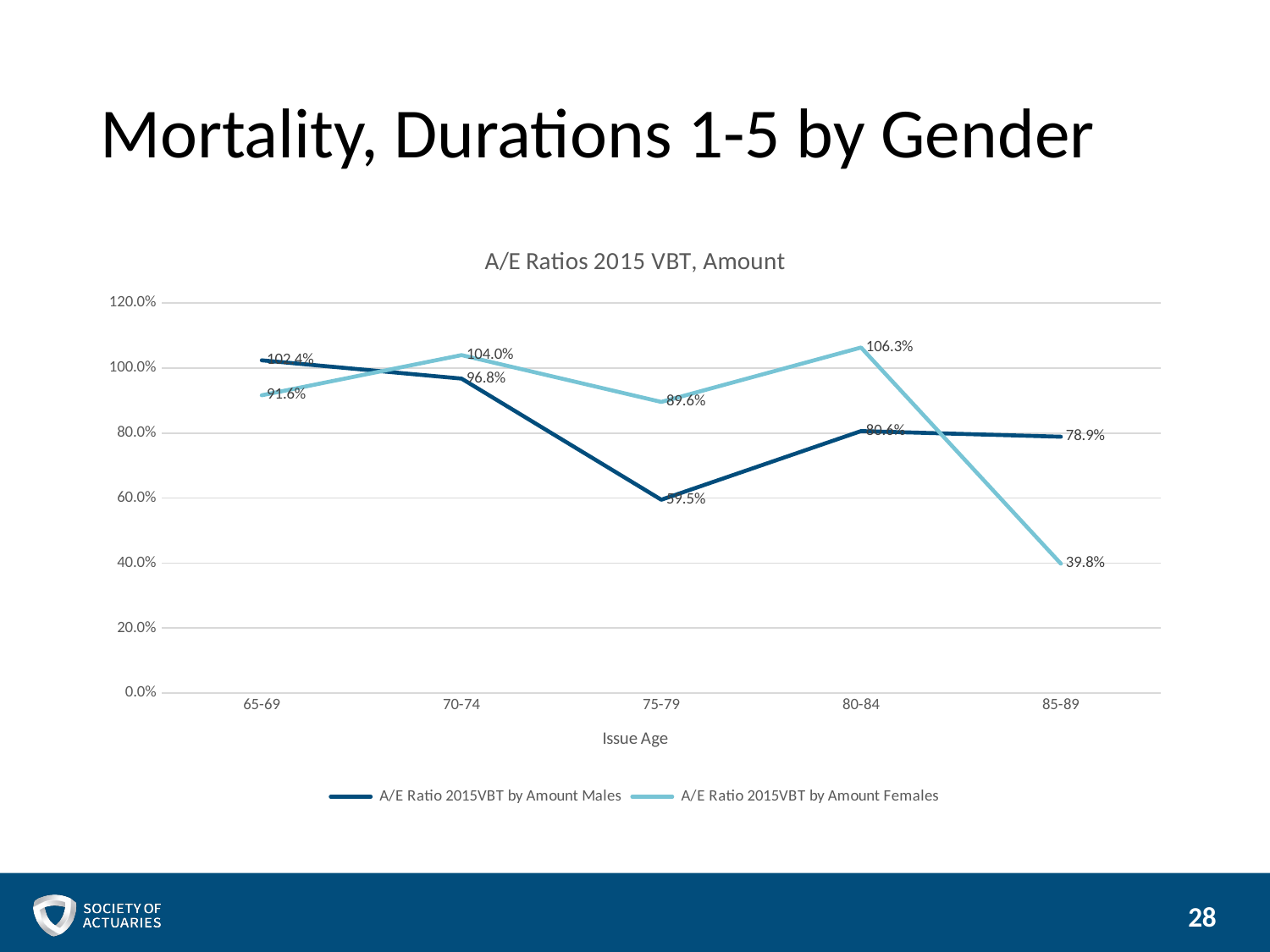
At which issue age is the male A/E ratio lowest? 75-79 What kind of chart is shown on the slide? line chart How many issue age categories are shown on the x axis? 5 What is the A/E ratio for females at issue age 85-89? 39.8% What is the A/E ratio for males at issue age 75-79? 59.5% How many series does the legend list? 2 At issue age 85-89, which series has the larger A/E ratio, males or females? males What is the title of the chart? A/E Ratios 2015 VBT, Amount At which issue age is the female A/E ratio highest? 80-84 What is the A/E ratio for females at issue age 70-74? 104.0% What is the difference between the female and male A/E ratios at issue age 75-79? 30.1% What is the A/E ratio for males at issue age 85-89? 78.9%